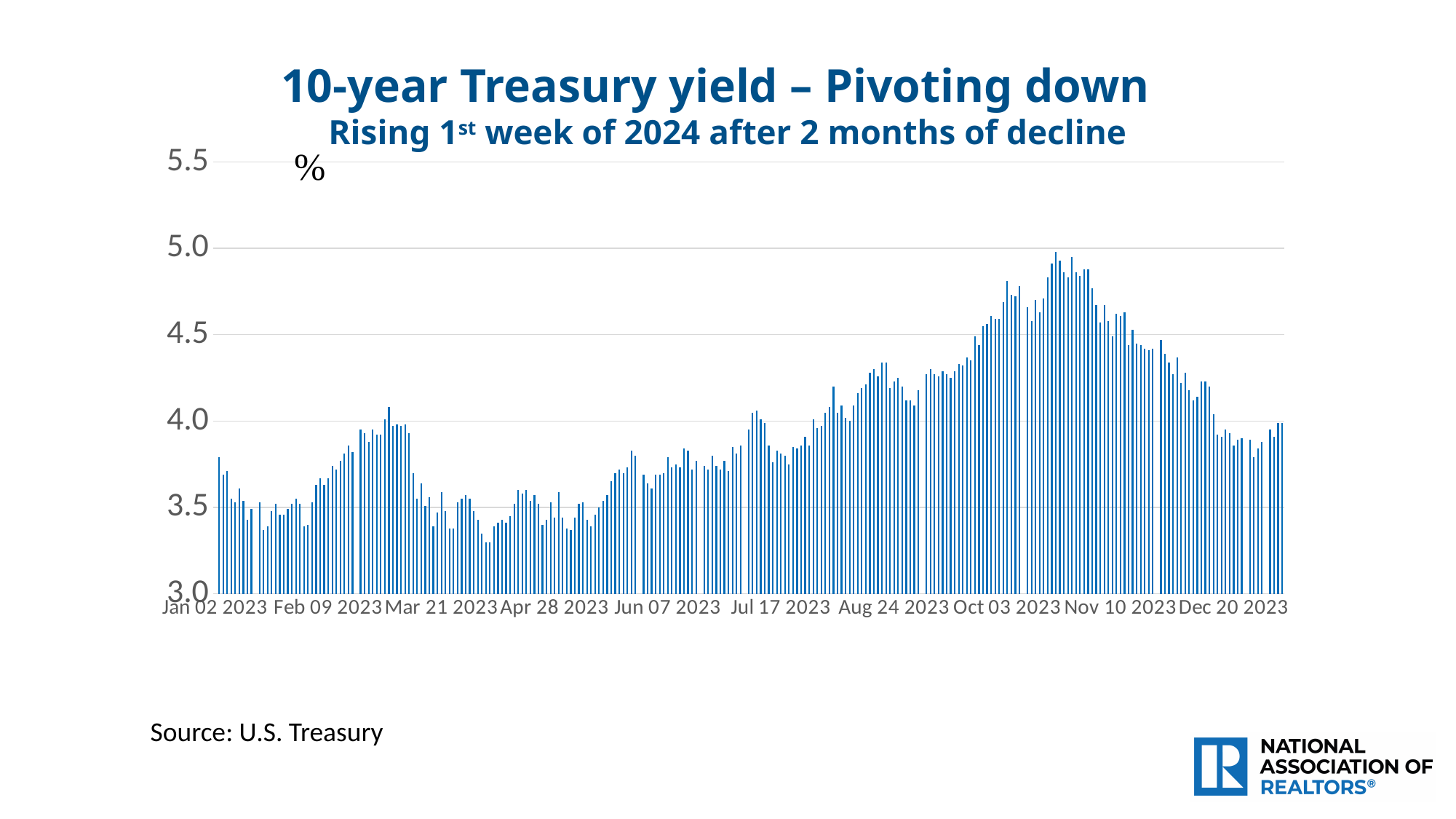
What is the title of the chart? 10-year Treasury yield – Pivoting down How many date labels are shown on the x axis? 10 Is the highest value on the chart greater or less than 4.5? greater Which is larger, the value for Oct 03 2023 or the value for Jan 02 2023? Oct 03 2023 Is the value for Jan 02 2023 greater or less than 4.0? less Between which two x-axis labels does the chart reach its highest values? Oct 03 2023 and Nov 10 2023 Do the values rise or fall between Nov 10 2023 and Dec 20 2023? fall What kind of chart is shown on the slide? bar chart What is the source cited for the chart data? U.S. Treasury Is the value for Apr 28 2023 greater or less than 4.0? less